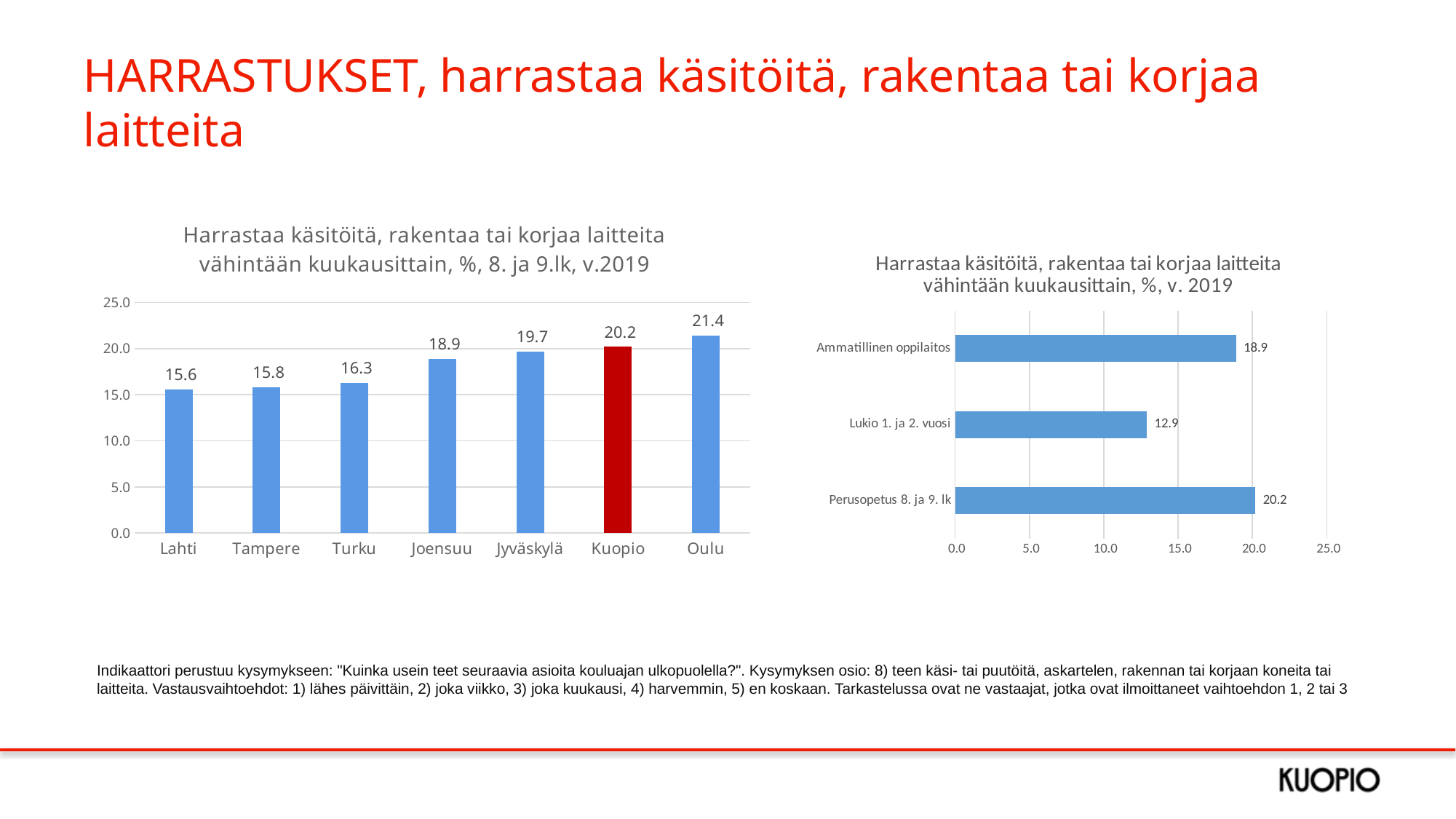
In the left chart (8. ja 9.lk by city), what is the value for Kuopio? 20.2 In the left chart (8. ja 9.lk by city), which city has the highest value? Oulu In the left chart (8. ja 9.lk by city), which bar is coloured red? Kuopio In the right chart (by school level), what is the value for Lukio 1. ja 2. vuosi? 12.9 In the right chart (by school level), which category has the highest value? Perusopetus 8. ja 9. lk What kind of chart is the right chart (by school level)? Bar chart In the left chart (8. ja 9.lk by city), which is larger, Joensuu or Turku? Joensuu In the left chart (8. ja 9.lk by city), how many cities are shown? 7 In the left chart (8. ja 9.lk by city), what is the difference between Oulu and Lahti? 5.8 In the right chart (by school level), what is the difference between Ammatillinen oppilaitos and Lukio 1. ja 2. vuosi? 6.0 In the left chart (8. ja 9.lk by city), which city has the lowest value? Lahti In the left chart (8. ja 9.lk by city), what is the value for Tampere? 15.8